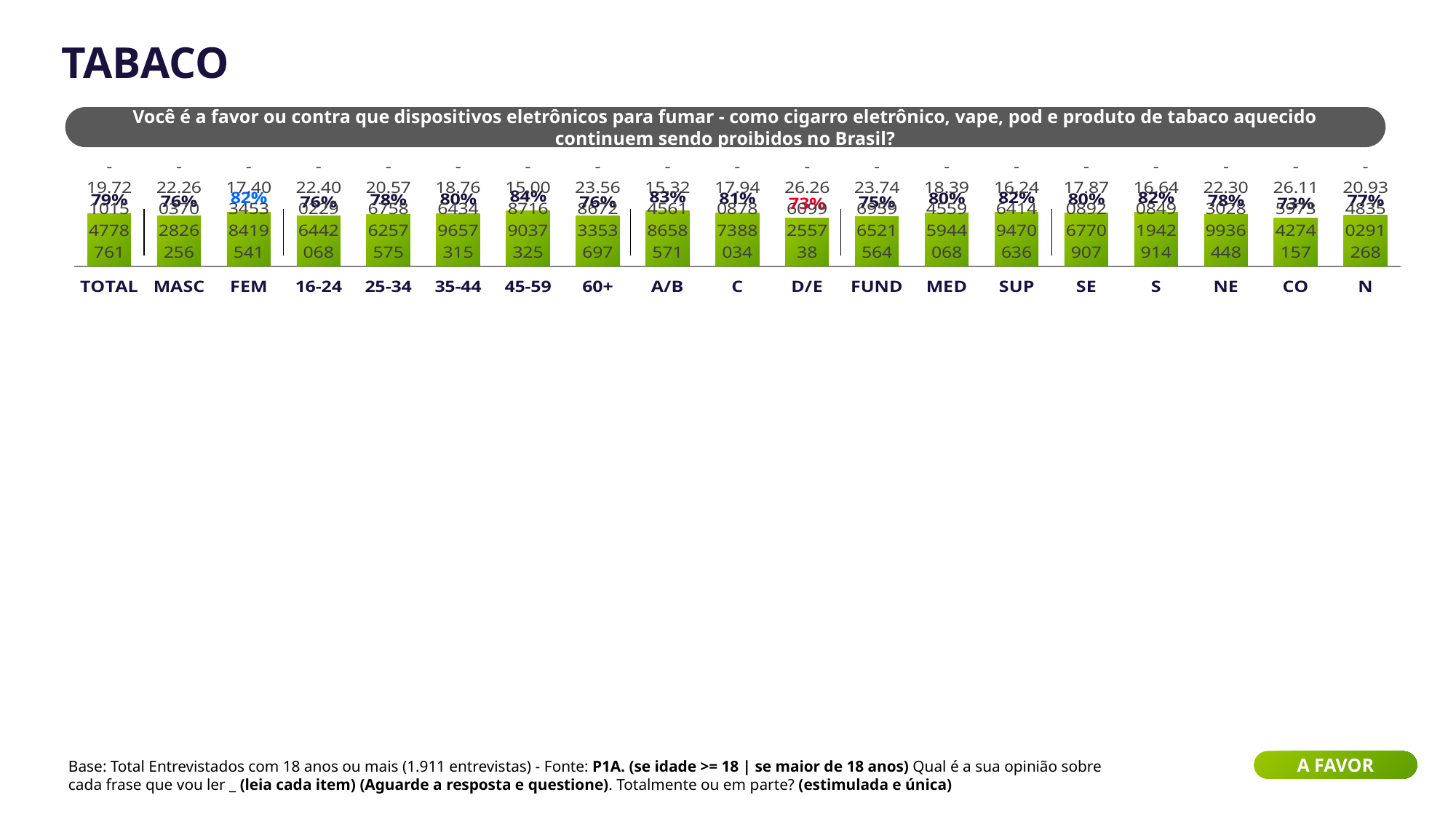
What is the label shown in the green box at the bottom right of the slide? A FAVOR Which is larger, the value for A/B or the value for C? A/B What is the value for D/E? 73% How many categories are shown on the x axis? 19 What is the value for the 60+ age group? 76% What is the difference between the values for FEM and MASC? 6% What is the difference between the values for 45-59 and 16-24? 8% What is the value for FEM? 82% What kind of chart is shown on the slide? Bar chart Which category has the highest value? 45-59 Among the regions SE, S, NE, CO and N, which has the lowest value? CO What is the value for TOTAL? 79%